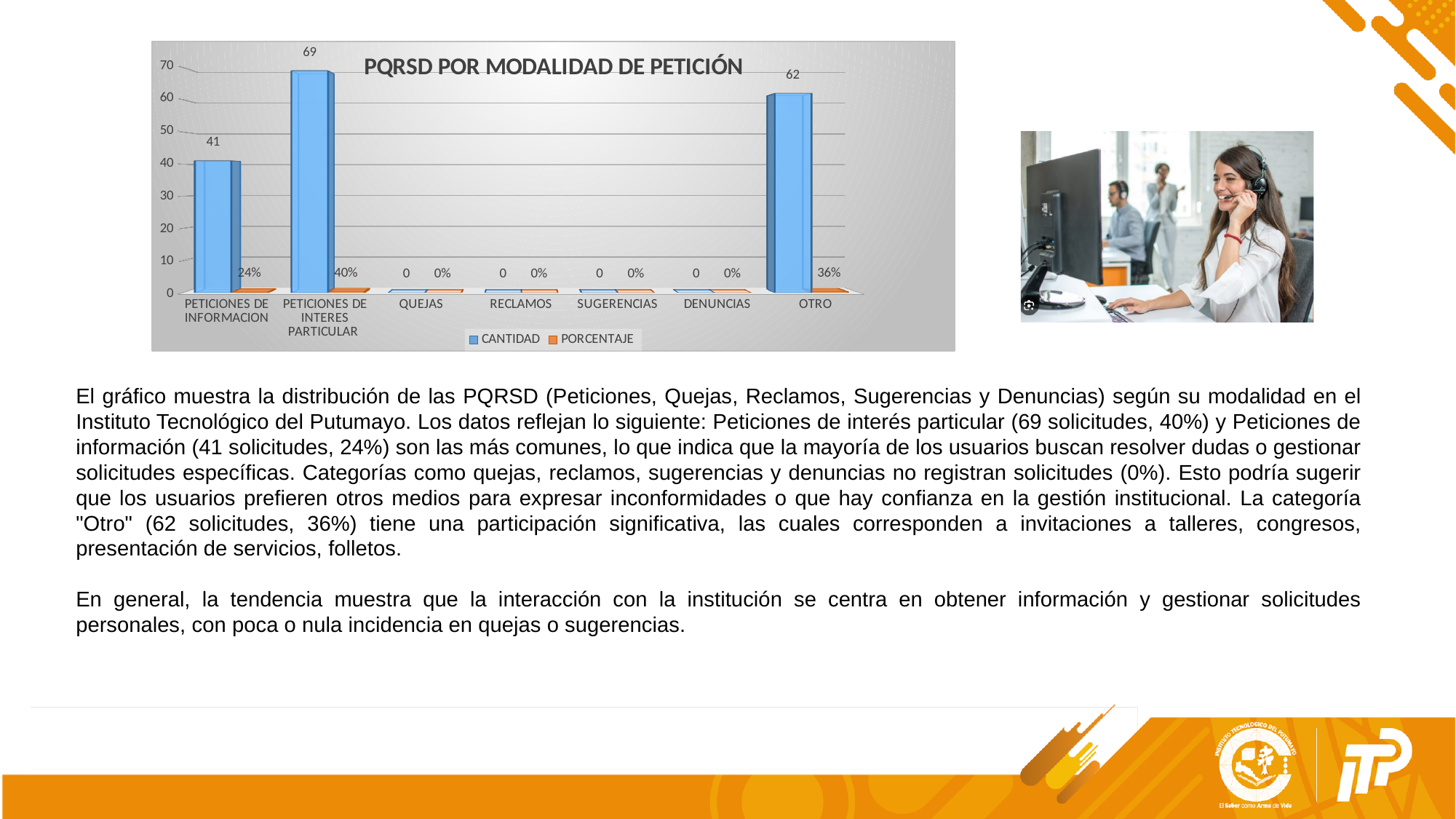
What is the difference in CANTIDAD between PETICIONES DE INTERES PARTICULAR and OTRO? 7 How many series does the legend list? 2 Which category has the highest CANTIDAD? PETICIONES DE INTERES PARTICULAR What is the CANTIDAD value for PETICIONES DE INTERES PARTICULAR? 69 Is the CANTIDAD value for OTRO greater or less than 50? greater What kind of chart is shown on the slide? Bar chart What is the title of the chart? PQRSD POR MODALIDAD DE PETICIÓN How many categories are shown on the x axis? 7 What is the PORCENTAJE value for OTRO? 36% What is the CANTIDAD value for PETICIONES DE INFORMACION? 41 Which has a larger CANTIDAD, PETICIONES DE INFORMACION or OTRO? OTRO What is the PORCENTAJE value for QUEJAS? 0%